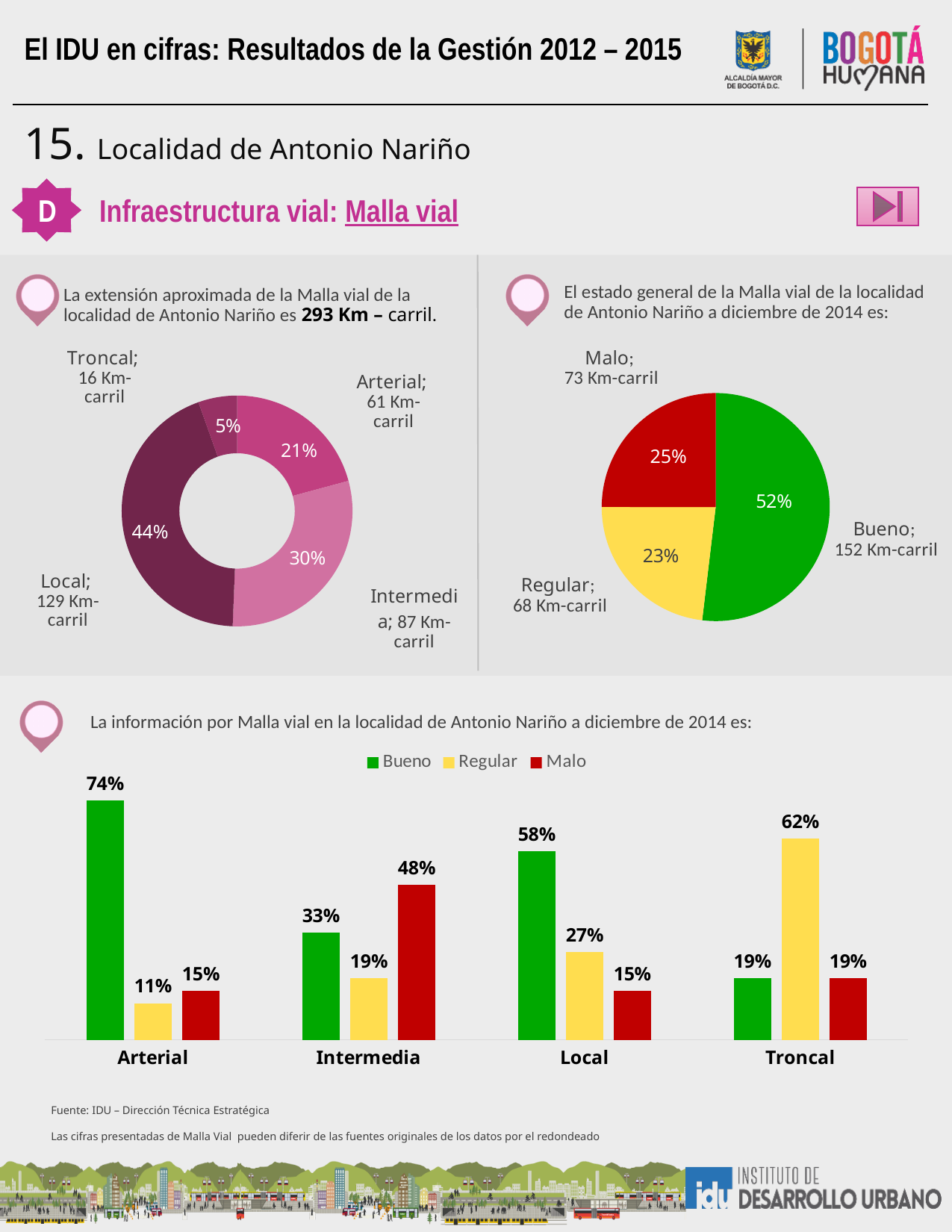
In the bar chart at the bottom, what is the Bueno value for Arterial? 74% In the pie chart on the top right, what is the difference in Km-carril between Bueno and Regular? 84 Km-carril In the donut chart on the top left, how many categories are shown? 4 What type of chart is shown at the bottom of the slide? Bar chart In the donut chart on the top left, what percentage share does Intermedia have? 30% In the donut chart on the top left, which category has the smallest share? Troncal In the donut chart on the top left, how many Km-carril does the Local category have? 129 Km-carril In the bar chart at the bottom, which category has the highest Regular value? Troncal In the bar chart at the bottom, how many series does the legend list? 3 In the bar chart at the bottom, which is larger for Intermedia: Bueno or Malo? Malo In the pie chart on the top right, how many Km-carril are in Malo condition? 73 Km-carril In the pie chart on the top right, what percentage of the road network is in Bueno condition? 52%